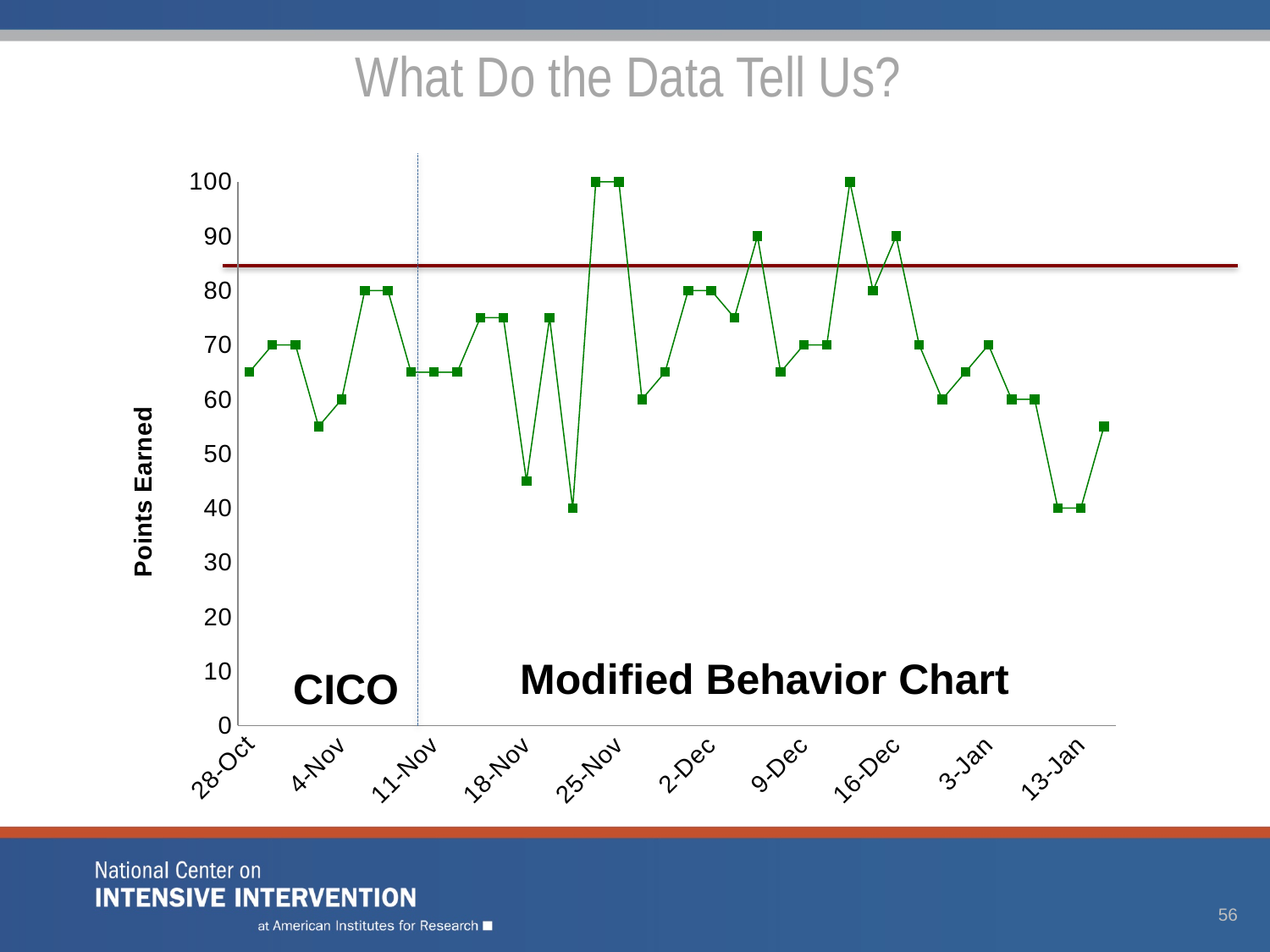
What is the label on the vertical axis? Points Earned How many date labels are shown on the horizontal axis? 10 Which has the larger value, 25-Nov or 13-Jan? 25-Nov What is the highest value reached by the plotted line? 100 What is the value plotted at 25-Nov? 100 Is the value for 25-Nov greater or less than 90? greater What kind of chart is shown on the slide? line chart What are the two phase labels written inside the chart area? CICO and Modified Behavior Chart Is the value for 4-Nov greater or less than 70? less What is the lowest value reached by the plotted line? 40 Is the value for 13-Jan greater or less than 50? less What is the value plotted at 13-Jan? 40